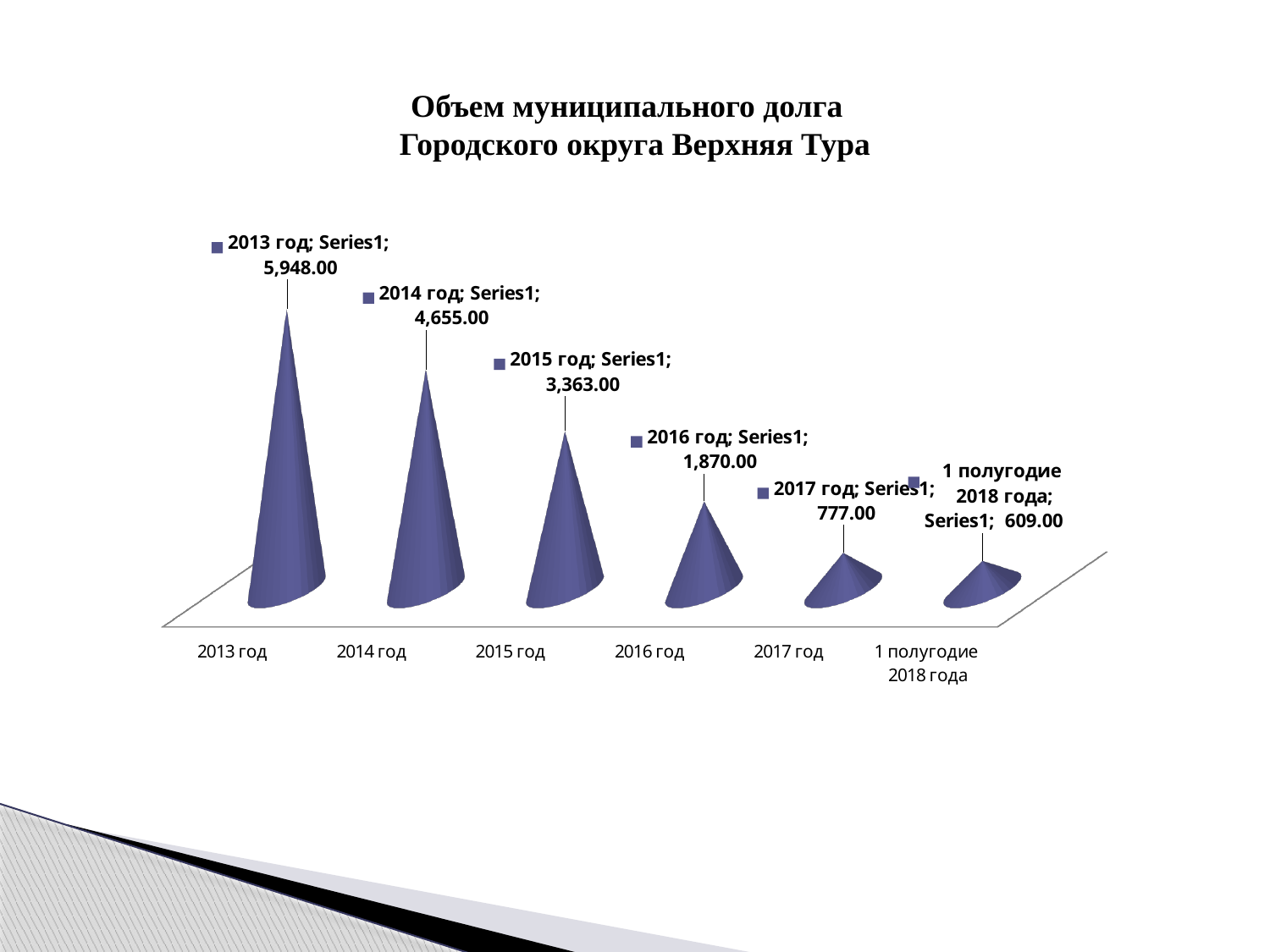
Which is larger, the value for 2015 год or the value for 2016 год? 2015 год Do the values rise or fall from 2013 год to 1 полугодие 2018 года? fall What kind of chart is shown on the slide? bar chart What is the value for 2016 год? 1,870.00 What is the difference between the values for 2017 год and 1 полугодие 2018 года? 168.00 What is the value for 1 полугодие 2018 года? 609.00 What is the difference between the values for 2013 год and 2014 год? 1,293.00 Which category has the highest value? 2013 год Which category has the lowest value? 1 полугодие 2018 года What is the value for 2013 год? 5,948.00 How many categories are shown on the x axis? 6 What is the title of the chart? Объем муниципального долга Городского округа Верхняя Тура